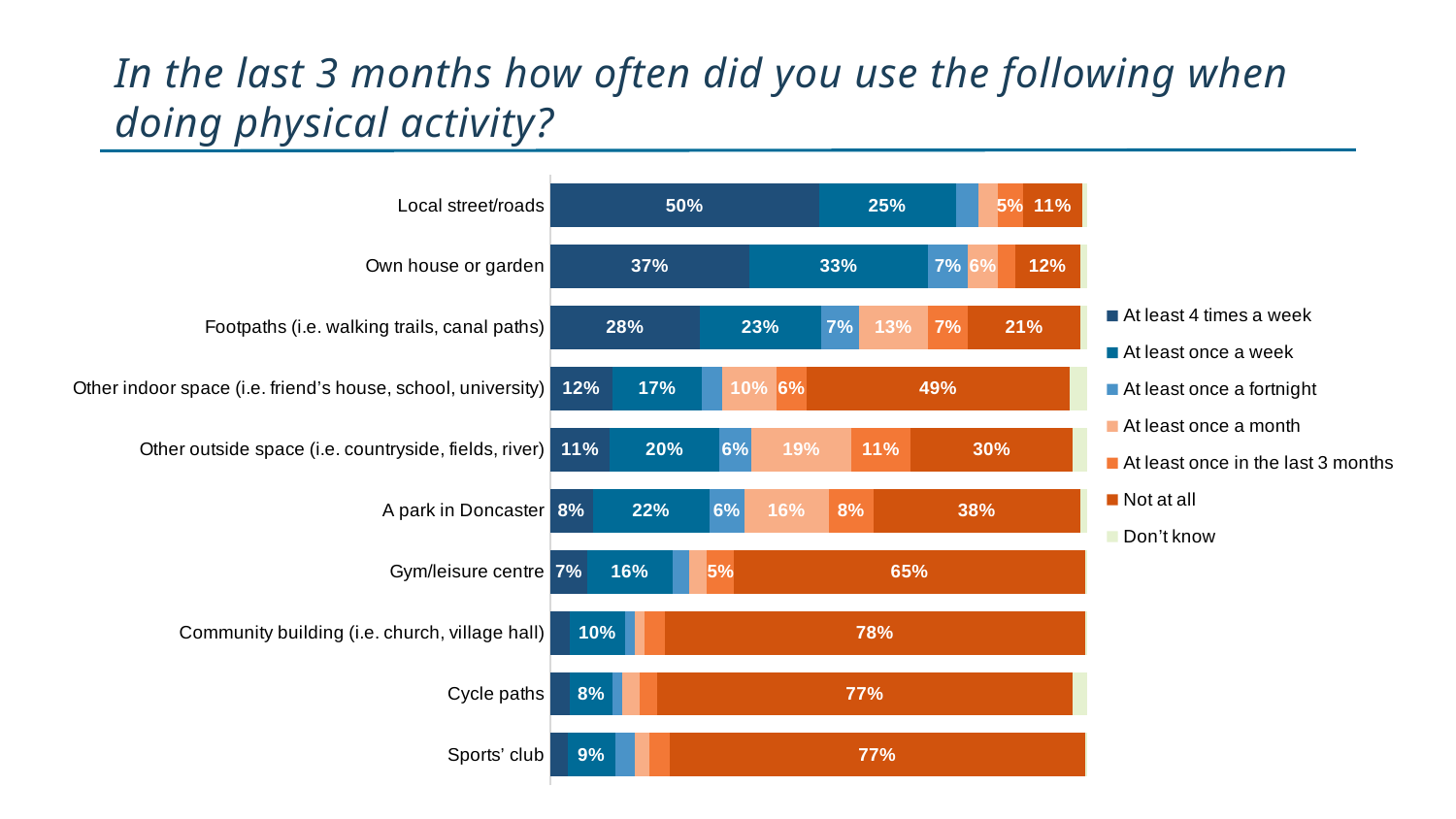
How many series does the legend list? 7 Which has a larger 'At least 4 times a week' value, Own house or garden or Footpaths? Own house or garden What is the last entry in the chart's legend? Don't know What is the 'Not at all' value for Gym/leisure centre? 65% What is the difference between the 'At least 4 times a week' values for Local street/roads and Footpaths? 22 percentage points What kind of chart is shown on the slide? Stacked bar chart Which category has the highest 'At least 4 times a week' value? Local street/roads What percentage of respondents used local street/roads at least 4 times a week? 50% What is the 'At least once a week' value for Own house or garden? 33% How many categories (places/spaces) are plotted on the chart? 10 Which category has the highest 'Not at all' value? Community building (i.e. church, village hall) What is the 'Not at all' value for Community building (i.e. church, village hall)? 78%